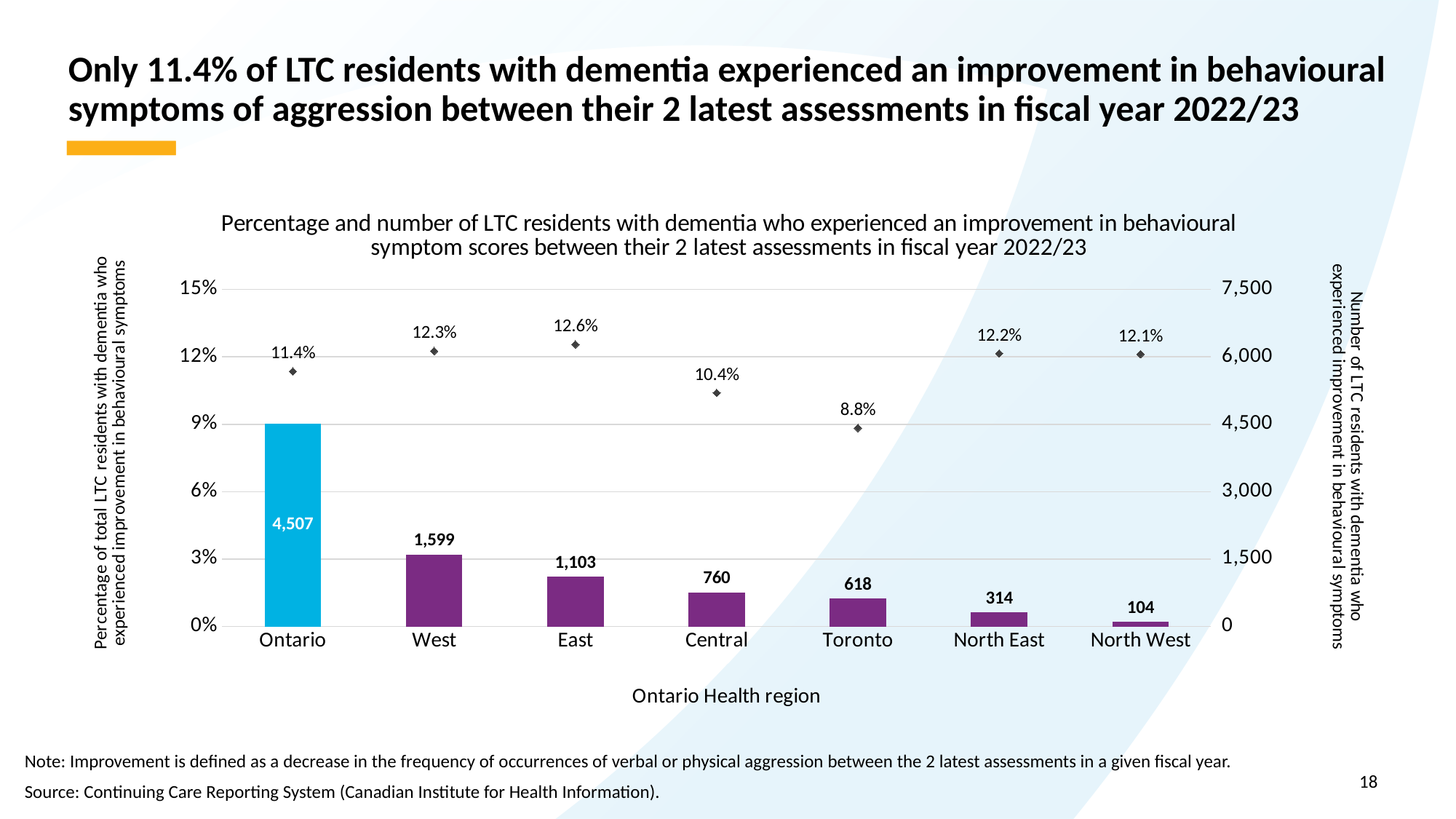
What is the number of residents shown for the North West region? 104 What is the x-axis title of the chart? Ontario Health region What percentage of LTC residents with dementia experienced improvement in behavioural symptoms in the Central region? 10.4% How many categories are shown on the x axis? 7 What kind of chart is this? Combined bar and line (marker) chart Which region has the lowest percentage of residents who experienced improvement? Toronto Which has a larger number of residents who experienced improvement, Central or Toronto? Central Among the regions excluding Ontario overall, which has the smallest number of residents who experienced improvement? North West Which region has the highest percentage of residents who experienced improvement? East What is the difference in the number of residents between the West and East regions? 496 What is the number of LTC residents with dementia who experienced improvement in behavioural symptoms for the West region? 1,599 What is the difference in percentage points between the East and Toronto regions? 3.8